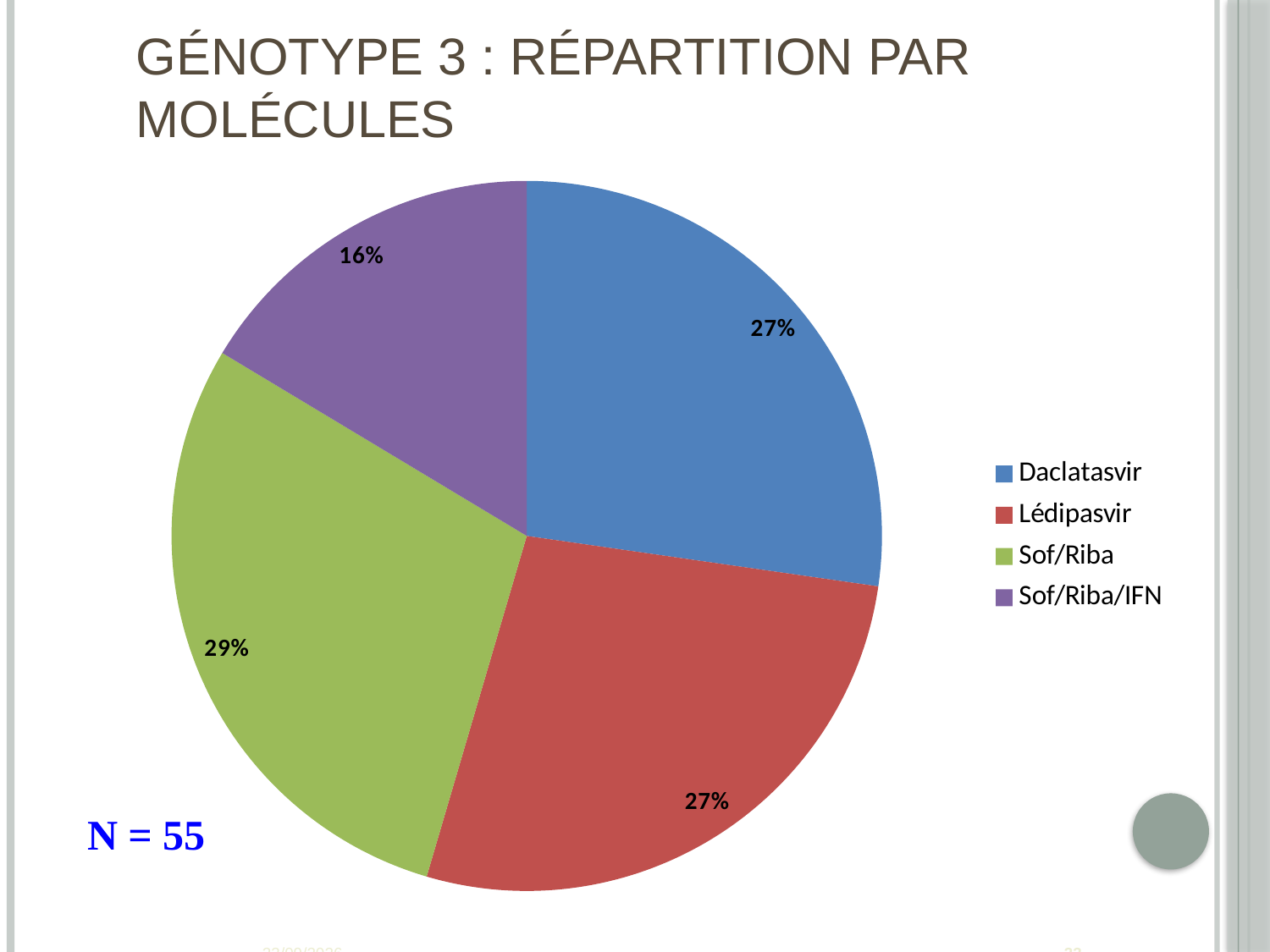
What is the value of N shown on the slide? 55 What is the difference in percentage points between the Sof/Riba share and the Sof/Riba/IFN share? 13 What share of the pie does Sof/Riba represent? 29% What share of the pie does Daclatasvir represent? 27% What share of the pie does Lédipasvir represent? 27% Which molecule has the largest share of the pie? Sof/Riba How many entries does the legend list? 4 How many slices does the pie chart have? 4 Which is larger, the share for Sof/Riba or the share for Daclatasvir? Sof/Riba What type of chart is shown on the slide? pie chart Which molecule has the smallest share of the pie? Sof/Riba/IFN